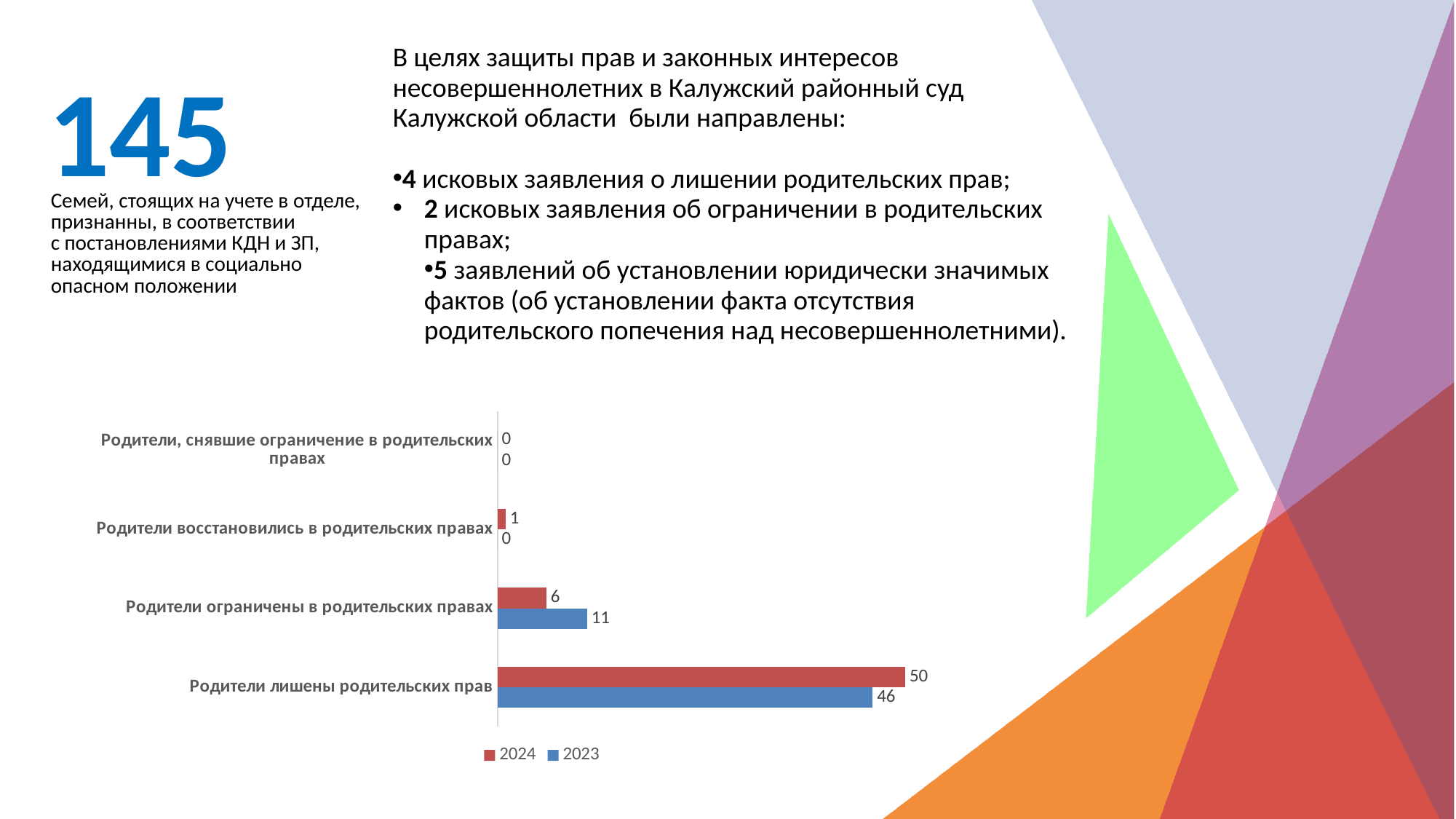
What is the 2024 value for "Родители лишены родительских прав"? 50 Which category has the highest 2024 value? Родители лишены родительских прав What is the 2024 value for "Родители восстановились в родительских правах"? 1 What is the difference between the 2024 and 2023 values for "Родители лишены родительских прав"? 4 What is the difference between the 2023 and 2024 values for "Родители ограничены в родительских правах"? 5 How many categories are shown in the chart? 4 What is the 2023 value for "Родители ограничены в родительских правах"? 11 Which colour represents the 2023 series in the chart? Blue What kind of chart is shown on the slide? Bar chart How many series does the chart legend list? 2 What is the 2023 value for "Родители лишены родительских прав"? 46 For "Родители ограничены в родительских правах", which year has the larger value, 2024 or 2023? 2023